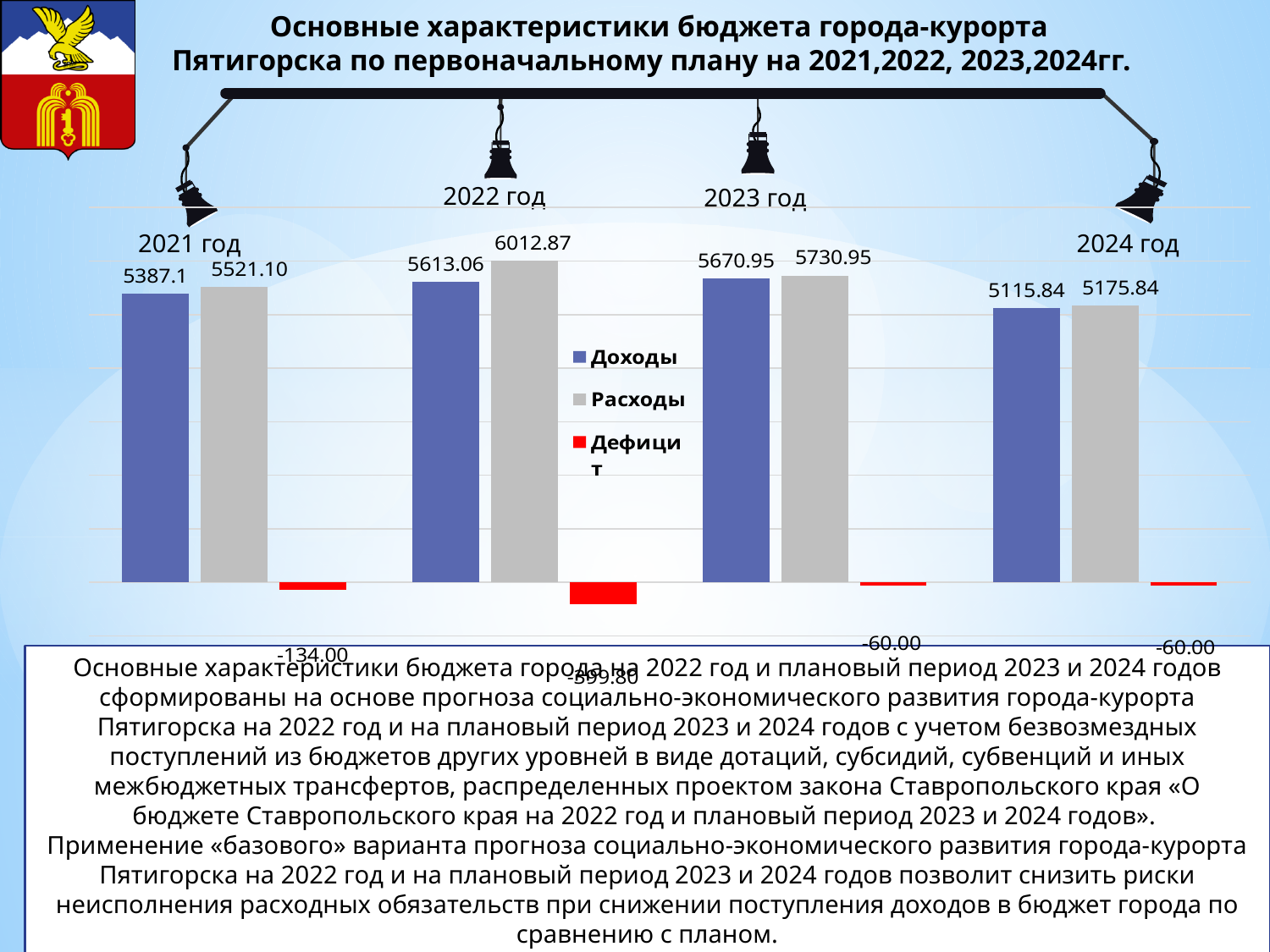
What colour are the Дефицит bars? Red What kind of chart is shown on the slide? Bar chart What is the value of Доходы for 2021 год? 5387.1 What is the value of Расходы for 2024 год? 5175.84 Which year has the lowest value of Доходы? 2024 год What is the value of Доходы for 2023 год? 5670.95 Which year has the highest value of Расходы? 2022 год What is the difference between Расходы and Доходы for 2023 год? 60.00 What is the value of Расходы for 2022 год? 6012.87 How many series does the legend list? 3 Which is larger for 2022 год: Доходы or Расходы? Расходы What is the value of Дефицит for 2021 год? -134.00